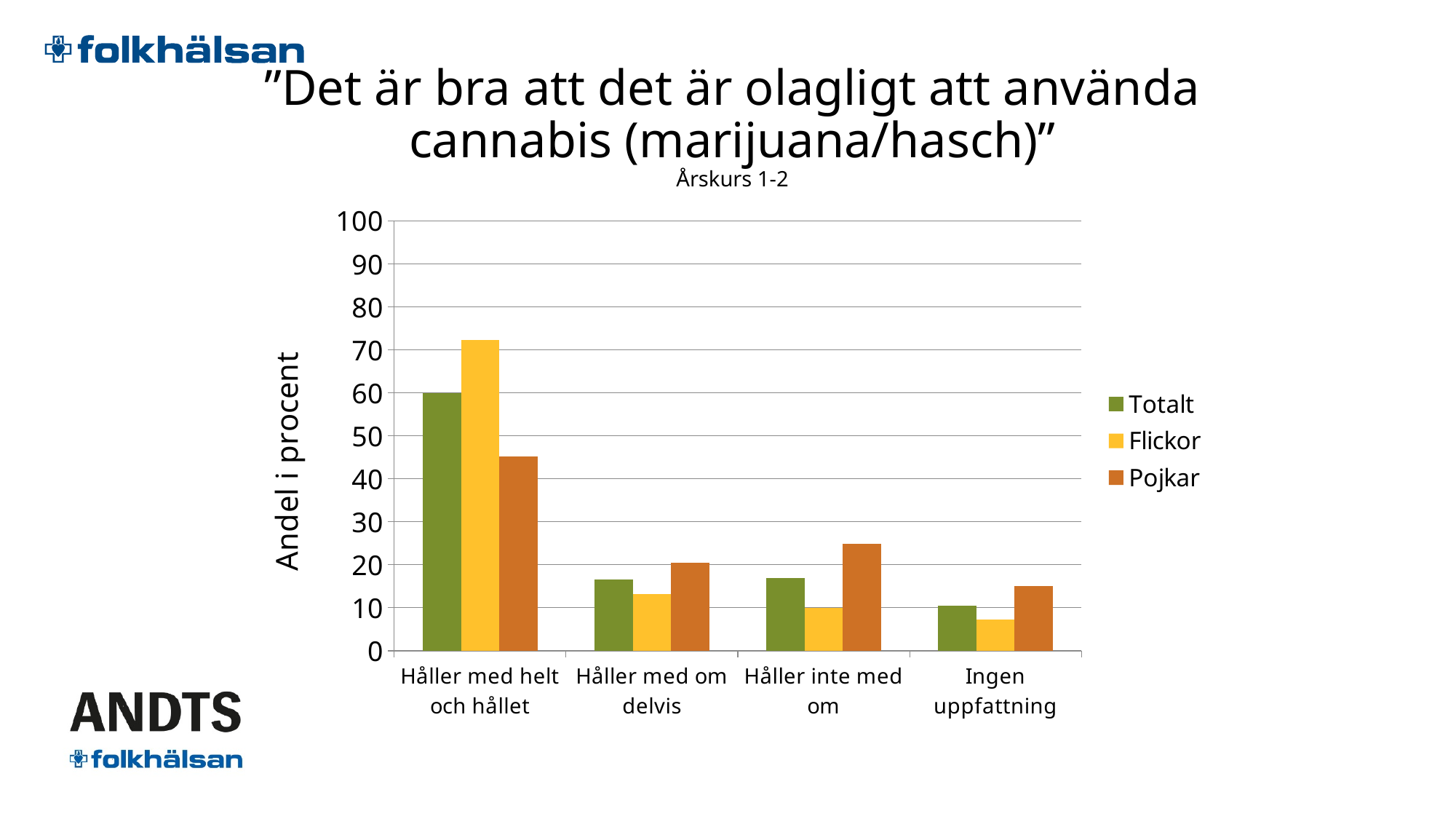
What is the label of the y axis? Andel i procent How many series does the legend list? 3 Is the value for Flickor in 'Håller med helt och hållet' greater or less than 70? greater Which series has the lowest value in the category 'Håller inte med om'? Flickor Which category has the highest value for Flickor? Håller med helt och hållet What kind of chart is shown on the slide? bar chart How many categories are shown on the x axis? 4 Which series has the highest value in the category 'Håller med helt och hållet'? Flickor Is the value for Flickor in 'Ingen uppfattning' greater or less than 10? less Is the value for Pojkar in 'Håller med helt och hållet' greater or less than 50? less Which is larger: Pojkar in 'Håller inte med om' or Pojkar in 'Håller med om delvis'? Pojkar in 'Håller inte med om' Which category has the lowest value for Flickor? Ingen uppfattning